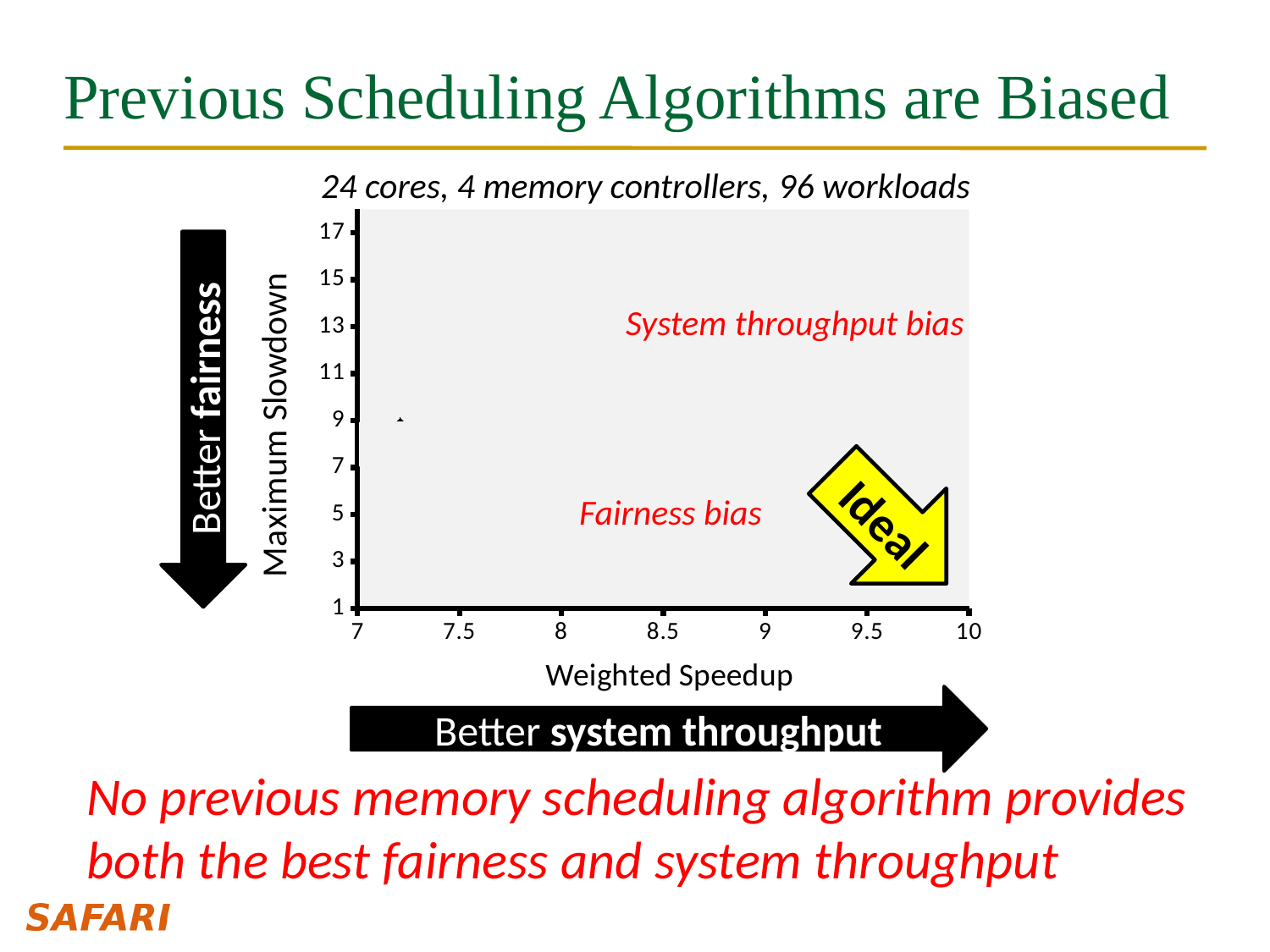
What is the label of the y axis of the chart? Maximum Slowdown What is the title of the chart? 24 cores, 4 memory controllers, 96 workloads How many data points are plotted on the chart? 1 Is the Weighted Speedup of the plotted point greater or less than 8? less Is the Weighted Speedup of the plotted point greater or less than 7.5? less Is the Maximum Slowdown of the plotted point greater or less than 11? less What kind of chart is shown on the slide? scatter chart